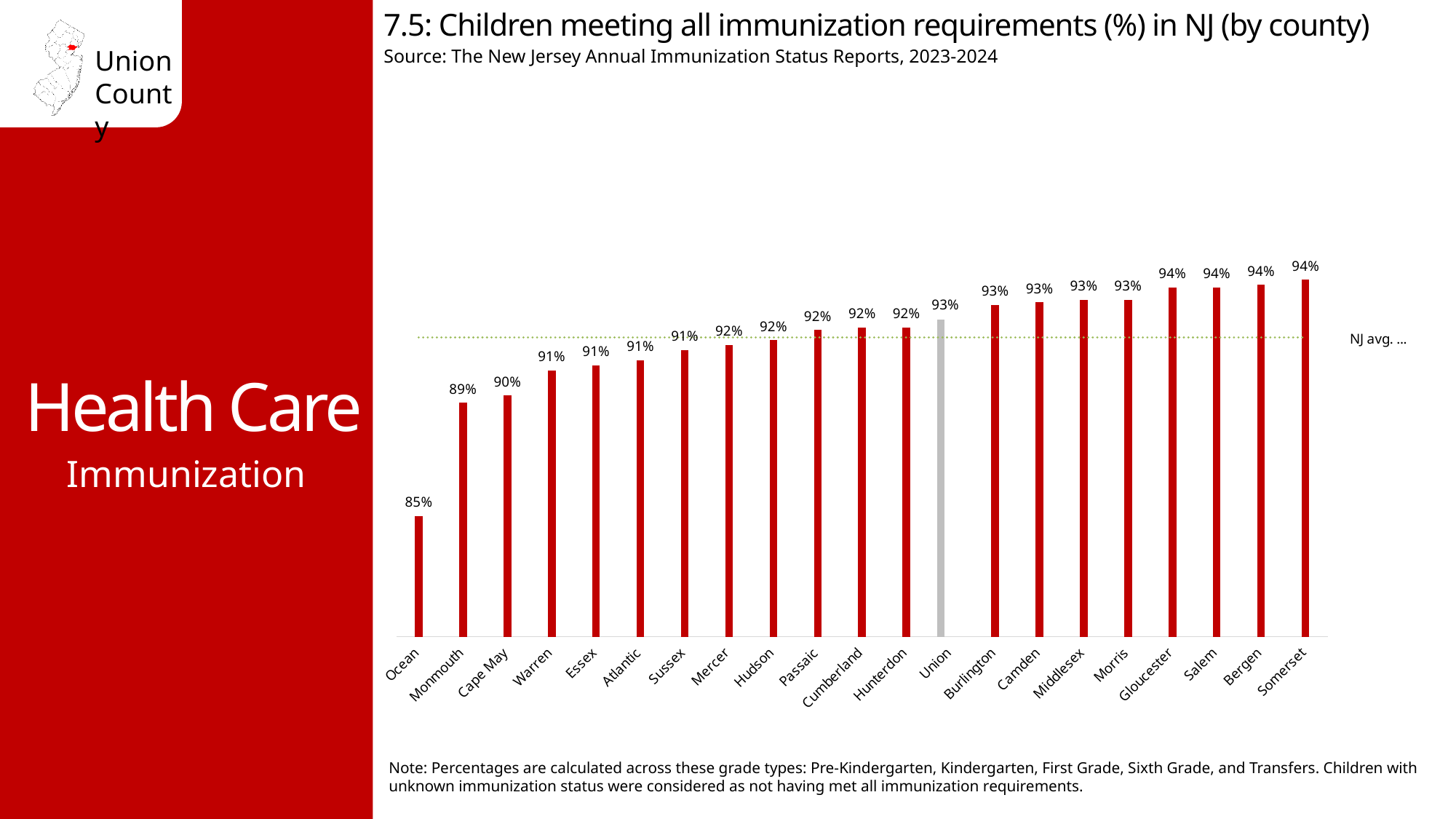
What is the difference between the values for Union and Monmouth? 4 percentage points Which county has the lowest percentage of children meeting all immunization requirements? Ocean What percentage of children in Union County met all immunization requirements? 93% What is the difference between the values for Somerset and Ocean? 9 percentage points What kind of chart is shown on the slide? Bar chart Do the values generally rise or fall from left to right across the counties? Rise What percentage is shown for Cape May? 90% How many counties are shown on the chart? 21 What is the value shown for Somerset County? 94% What is the value shown for Ocean County? 85% Which has a higher value, Cape May or Union? Union Which has a higher value, Ocean or Monmouth? Monmouth